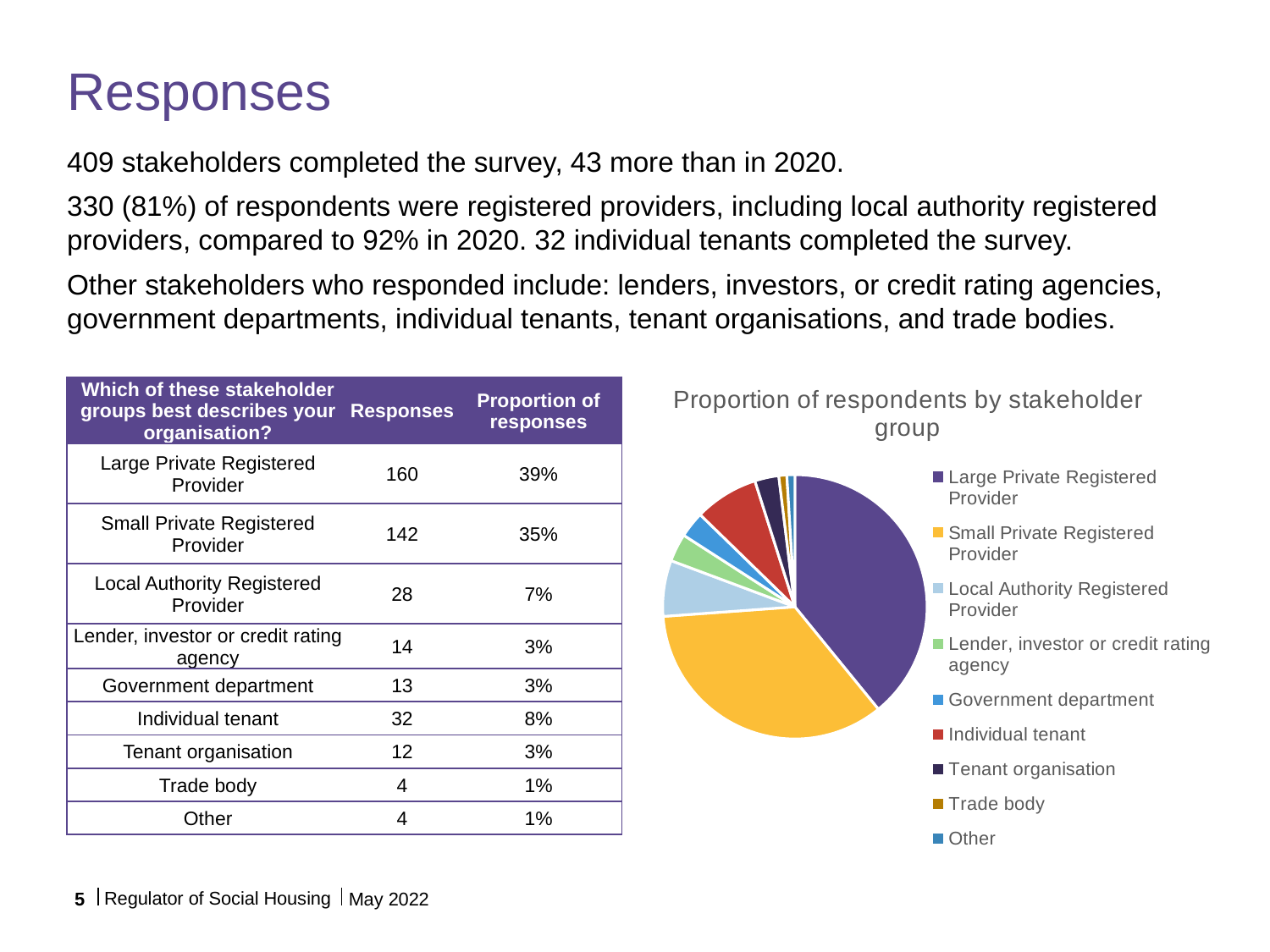
What colour is the Large Private Registered Provider slice in the pie chart? Purple What proportion of responses does the Local Authority Registered Provider slice represent? 7% What proportion of responses does the Large Private Registered Provider slice represent? 39% What proportion of responses does the Individual tenant slice represent? 8% What kind of chart is shown on the slide? Pie chart How many stakeholder groups does the pie chart's legend list? 9 What is the title of the pie chart? Proportion of respondents by stakeholder group Which slice is larger in the pie chart: Individual tenant or Government department? Individual tenant By how many percentage points does the Large Private Registered Provider share exceed the Small Private Registered Provider share? 4 percentage points Which stakeholder group has the largest slice of the pie chart? Large Private Registered Provider Which slice is larger in the pie chart: Local Authority Registered Provider or Lender, investor or credit rating agency? Local Authority Registered Provider